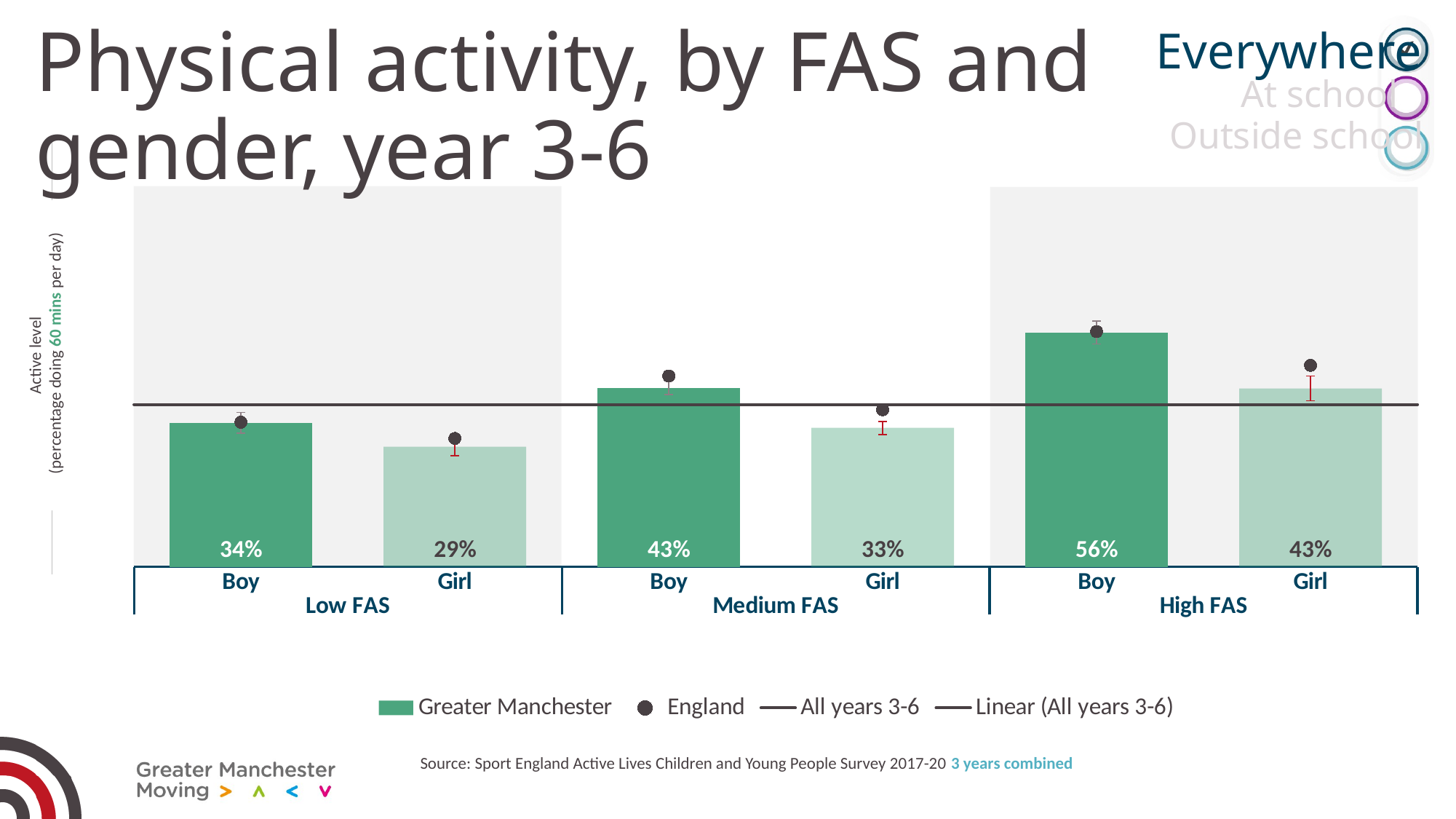
What is the Greater Manchester value for Medium FAS girls? 33% Which bar has the lowest Greater Manchester value? Low FAS Girl How many entries does the legend list? 4 What kind of chart is shown on the slide? Bar chart Which is larger, the Greater Manchester value for Low FAS girls or Medium FAS girls? Medium FAS girls What is the difference between the High FAS boy and High FAS girl Greater Manchester values? 13% How many bars are plotted in the chart? 6 Which bar has the highest Greater Manchester value? High FAS Boy Which is larger, the Greater Manchester value for Medium FAS boys or for High FAS girls? They are equal (43%) What is the Greater Manchester value for High FAS boys? 56% What is the difference between the Medium FAS boy and Low FAS boy Greater Manchester values? 9% What is the Greater Manchester value for Low FAS boys? 34%